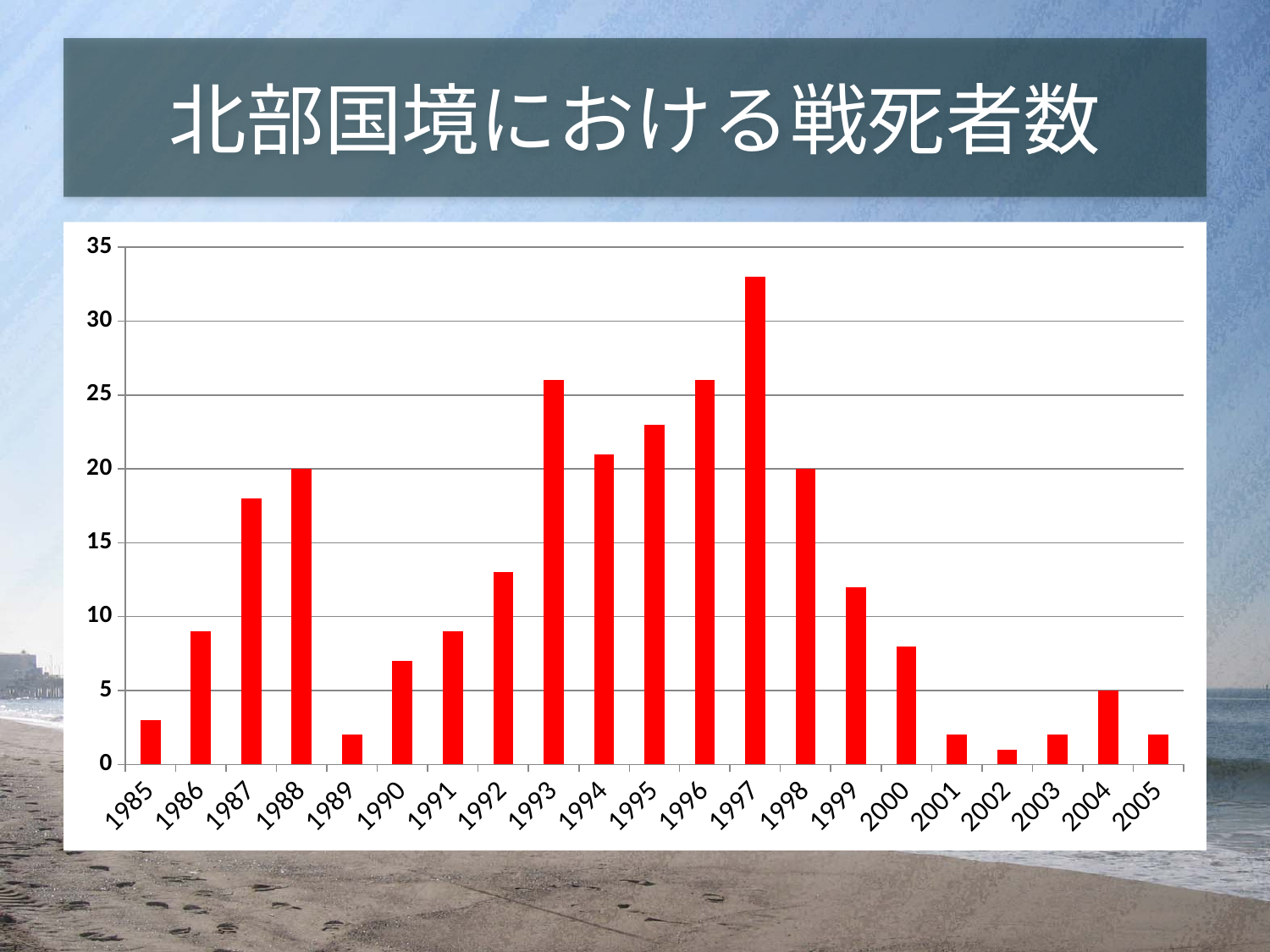
What is the value for 1998? 20 Do the values rise or fall from 1997 to 2002? fall Which year has the highest value in the chart? 1997 Which year has the lowest value in the chart? 2002 Is the value for 1989 greater or less than 5? less What is the value for 1988? 20 Is the value for 1997 greater or less than 30? greater Which is larger, the value for 1987 or the value for 1988? 1988 Is the value for 1993 greater or less than 25? greater What is the title of the chart? 北部国境における戦死者数 What type of chart is shown on the slide? bar chart How many years are shown on the x axis of the chart? 21